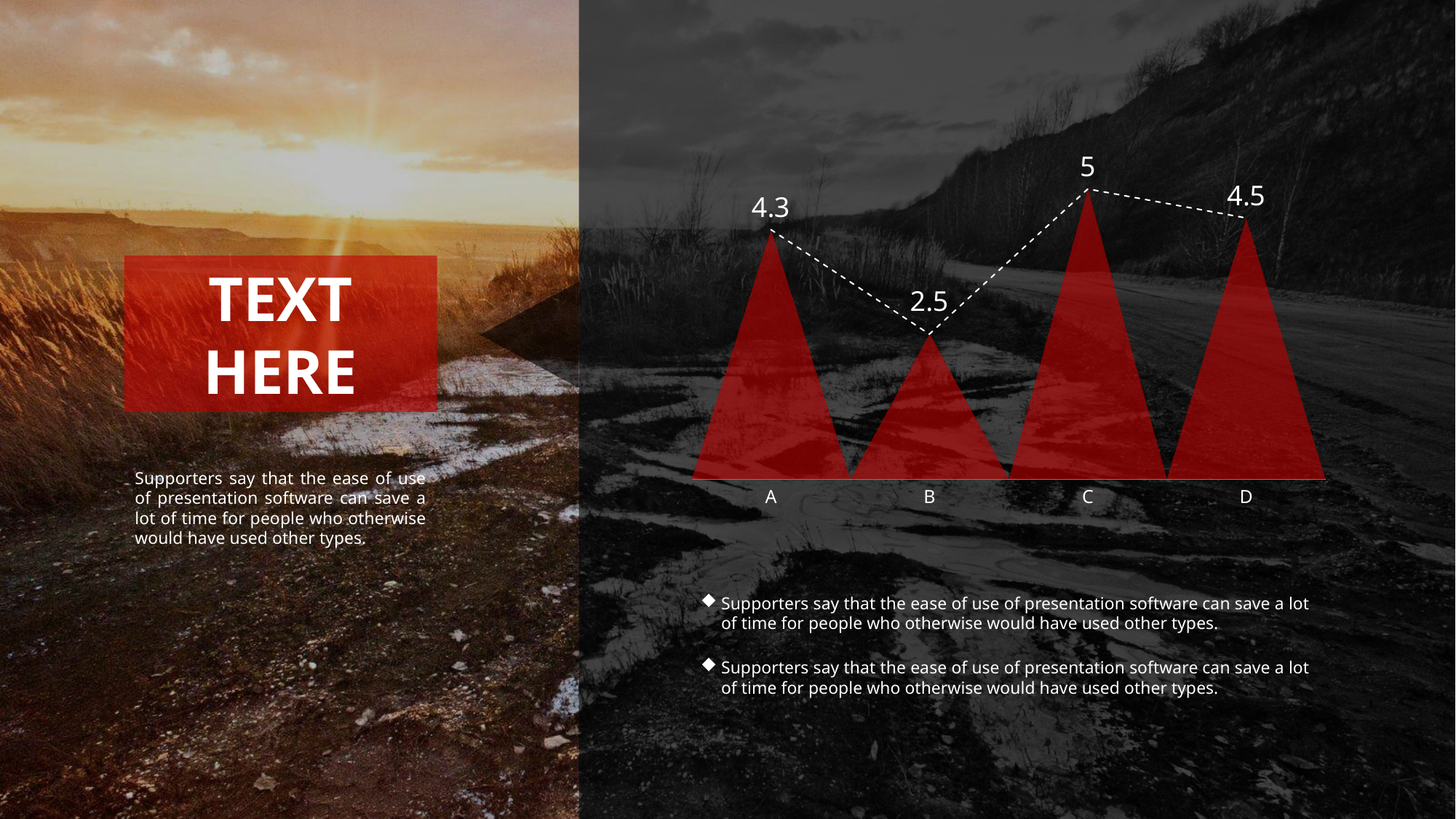
What is the difference between the values for C and B? 2.5 What is the difference between the values for D and A? 0.2 How many categories are shown on the chart? 4 Which category has the highest value? C What is the value for category B? 2.5 Which is larger, the value for A or the value for D? D What colour are the bars on the chart? red Which category has the lowest value? B What is the value for category C? 5 What is the value for category A? 4.3 Does the value rise or fall from category A to category B? fall What is the value for category D? 4.5